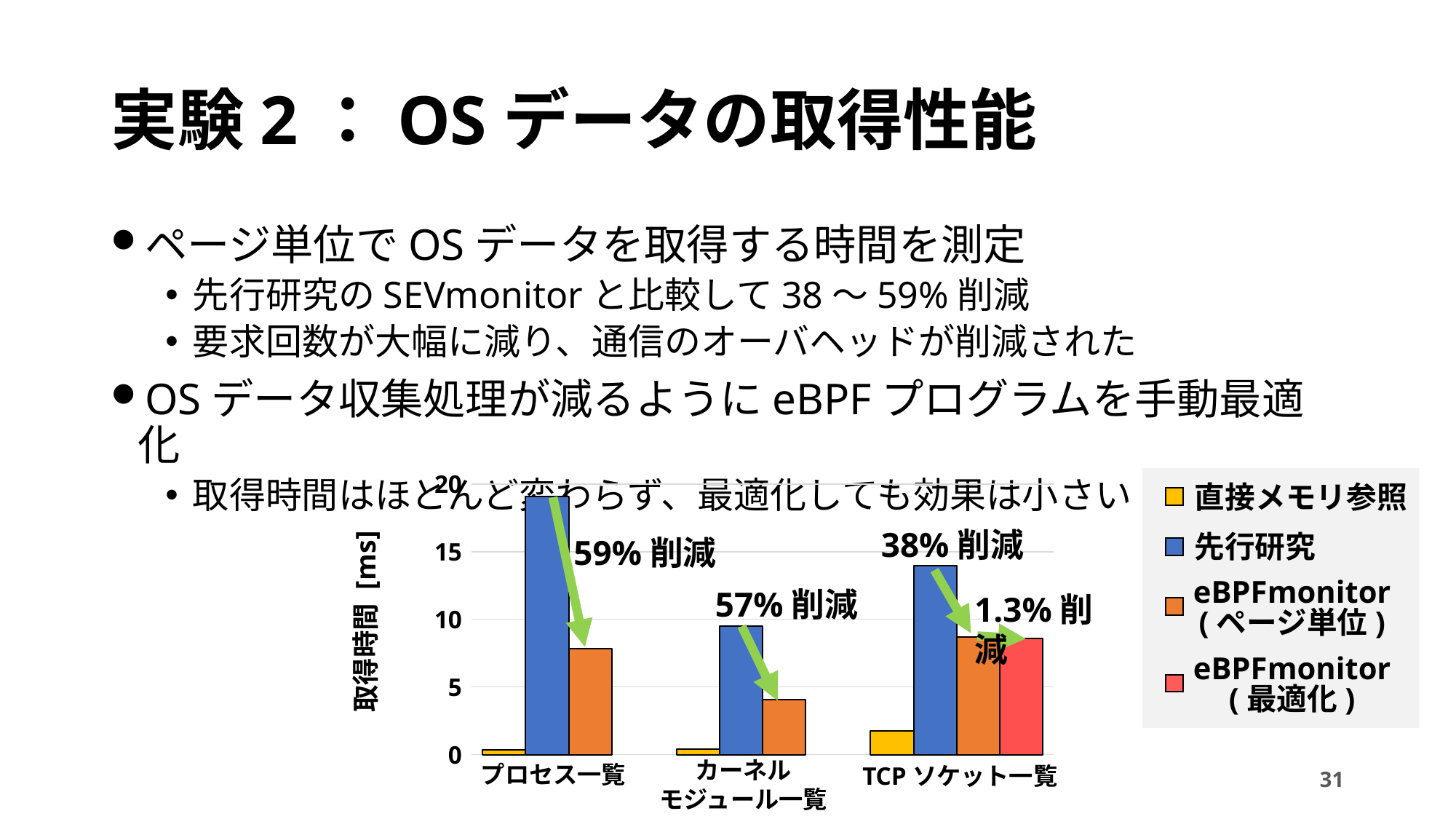
Is the eBPFmonitor (ページ単位) value for カーネルモジュール一覧 greater or less than 5? less How many series does the chart's legend list? 4 How many categories are shown on the x axis of the chart? 3 What is the label of the chart's y axis? 取得時間 [ms] What reduction percentage is annotated for カーネルモジュール一覧? 57% 削減 Is the 先行研究 value for プロセス一覧 greater or less than 15? greater Which category has the lowest 先行研究 bar? カーネルモジュール一覧 What kind of chart is shown on the slide? bar chart Is the eBPFmonitor (ページ単位) value for プロセス一覧 greater or less than 10? less Which category has the highest 先行研究 bar? プロセス一覧 For TCP ソケット一覧, which is larger: the 先行研究 bar or the eBPFmonitor (ページ単位) bar? 先行研究